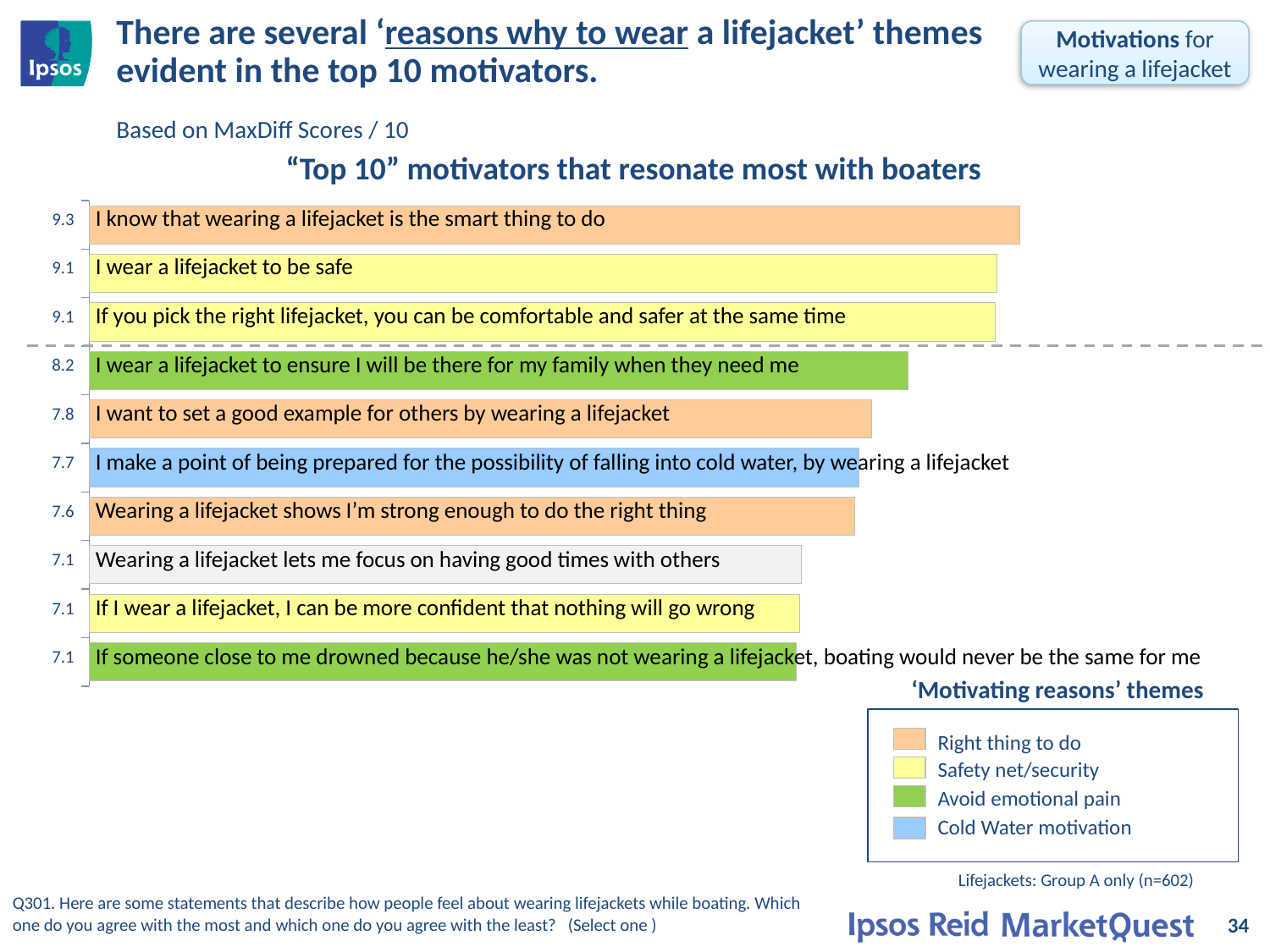
Which motivator has the highest MaxDiff score? I know that wearing a lifejacket is the smart thing to do What is the difference between the MaxDiff scores for "I know that wearing a lifejacket is the smart thing to do" and "I wear a lifejacket to be safe"? 0.2 What kind of chart is shown on the slide? Bar chart Which theme does the legend associate with the green bars? Avoid emotional pain What is the lowest MaxDiff score shown on the chart? 7.1 What is the MaxDiff score for "I know that wearing a lifejacket is the smart thing to do"? 9.3 How many motivators are shown on the chart? 10 Which has a higher MaxDiff score: "I want to set a good example for others by wearing a lifejacket" or "Wearing a lifejacket lets me focus on having good times with others"? I want to set a good example for others by wearing a lifejacket How many themes does the 'Motivating reasons' themes legend list? 4 What is the MaxDiff score for "I wear a lifejacket to ensure I will be there for my family when they need me"? 8.2 What is the difference between the MaxDiff scores for "I wear a lifejacket to ensure I will be there for my family when they need me" and "Wearing a lifejacket shows I'm strong enough to do the right thing"? 0.6 What is the MaxDiff score for "I make a point of being prepared for the possibility of falling into cold water, by wearing a lifejacket"? 7.7